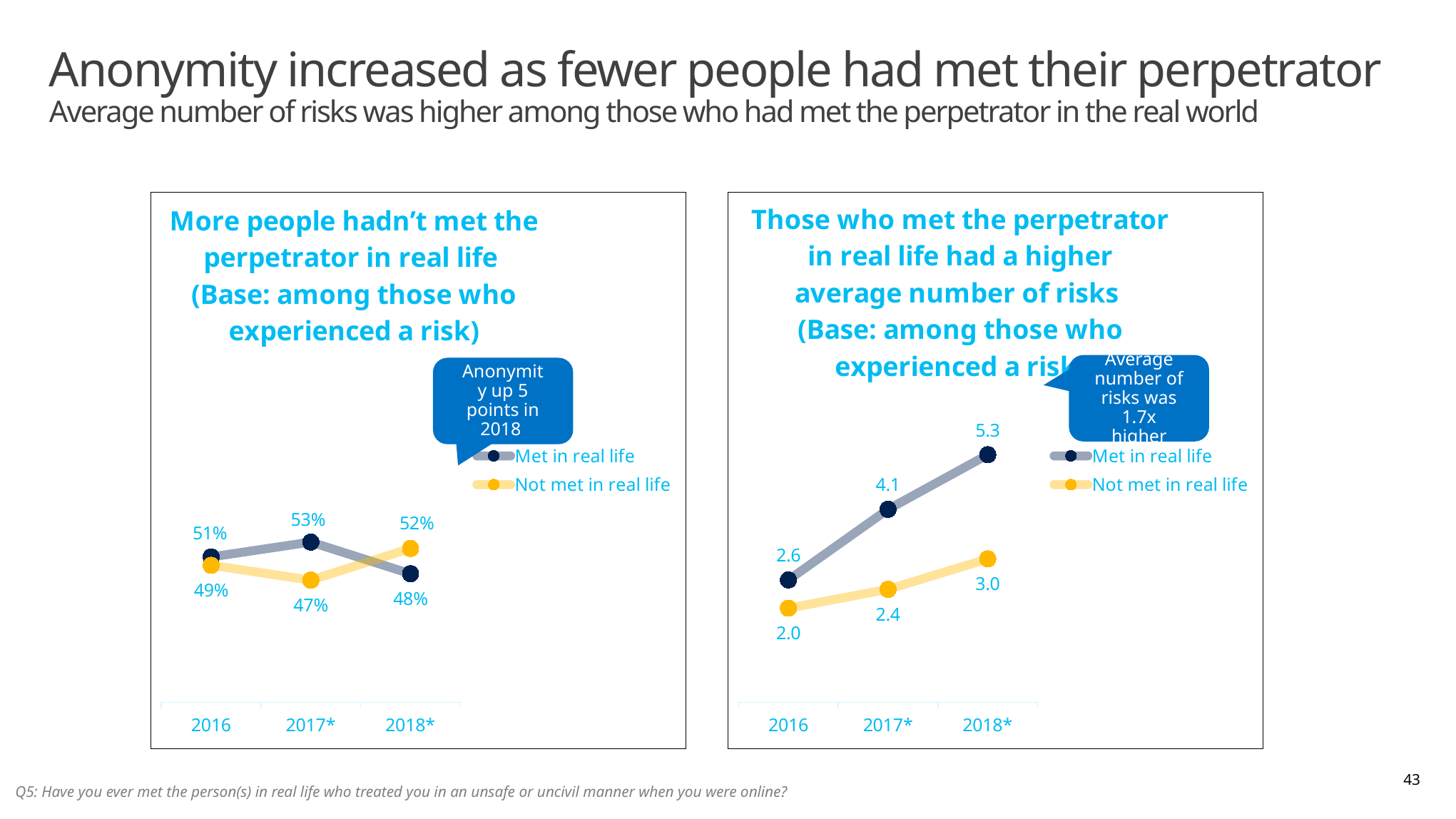
In the left chart, what was the value for 'Not met in real life' in 2018*? 52% In the left chart, which series had the higher value in 2016? Met in real life In the right chart, does the 'Met in real life' series rise or fall from 2016 to 2018*? Rise In the right chart, what was the average number of risks for 'Not met in real life' in 2016? 2.0 In the left chart, in which year was 'Not met in real life' lowest? 2017* What type of chart is the left chart? Line chart In the left chart, what is the difference between 'Not met in real life' and 'Met in real life' in 2018*? 4 percentage points In the right chart, what is the difference between 'Met in real life' and 'Not met in real life' in 2017*? 1.7 In the right chart, what was the average number of risks for 'Met in real life' in 2018*? 5.3 In the right chart, in which year was 'Not met in real life' highest? 2018* In the left chart, what was the value for 'Met in real life' in 2017*? 53% How many series does the legend of the right chart list? 2